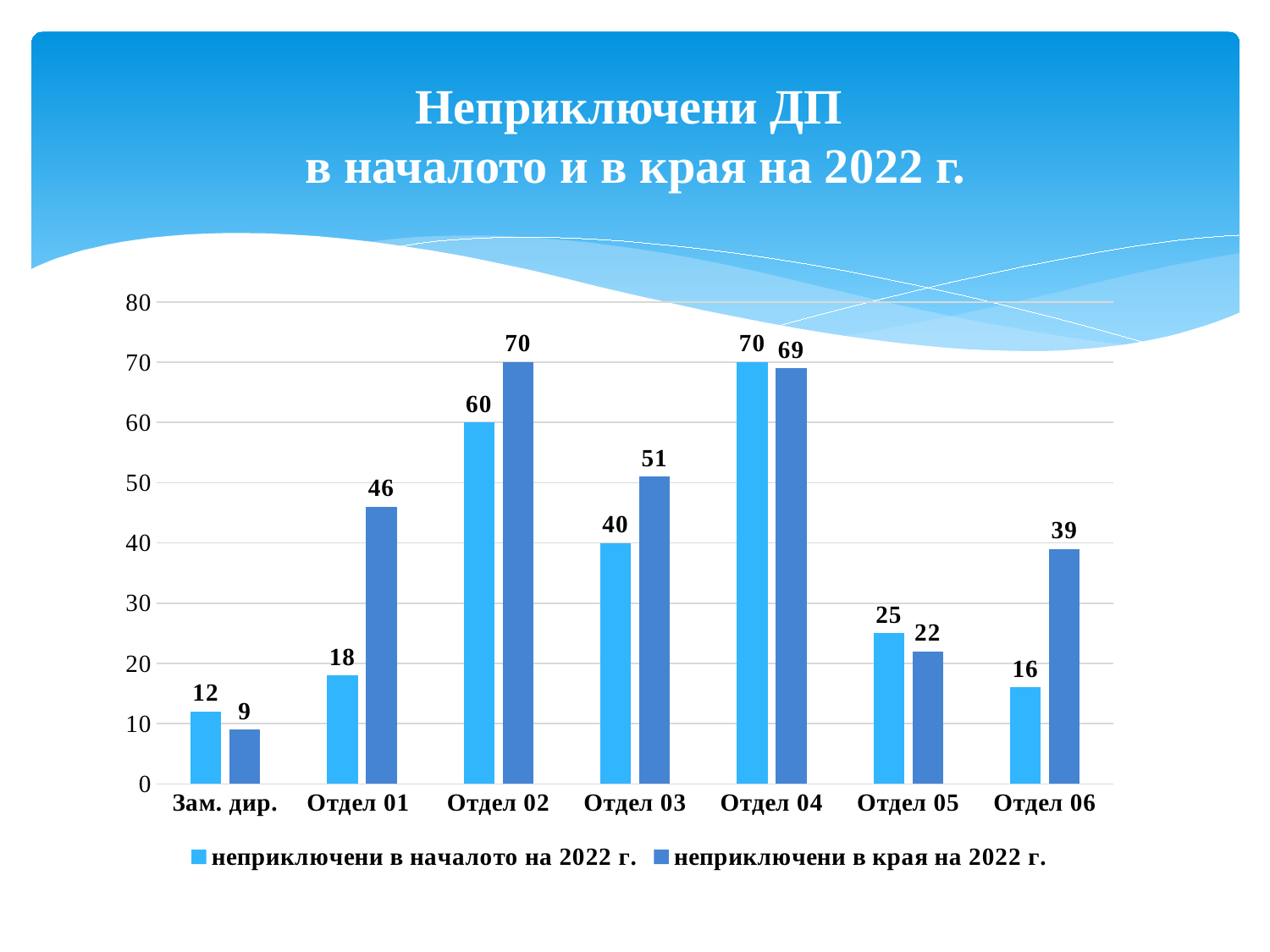
What is the title of the chart? Неприключени ДП в началото и в края на 2022 г. What is the value for Отдел 06 in the series 'неприключени в края на 2022 г.'? 39 Which category has the lowest value in the series 'неприключени в края на 2022 г.'? Зам. дир. What is the value for Зам. дир. in the series 'неприключени в края на 2022 г.'? 9 Which category has the highest value in the series 'неприключени в началото на 2022 г.'? Отдел 04 How many categories are shown on the x axis? 7 For Отдел 05, which series has the larger value: 'неприключени в началото на 2022 г.' or 'неприключени в края на 2022 г.'? неприключени в началото на 2022 г. What is the value for Отдел 02 in the series 'неприключени в началото на 2022 г.'? 60 What kind of chart is shown on the slide? Bar chart How many series does the legend list? 2 What is the difference between the 'неприключени в началото на 2022 г.' and 'неприключени в края на 2022 г.' values for Отдел 04? 1 What is the difference between the 'неприключени в края на 2022 г.' and 'неприключени в началото на 2022 г.' values for Отдел 01? 28